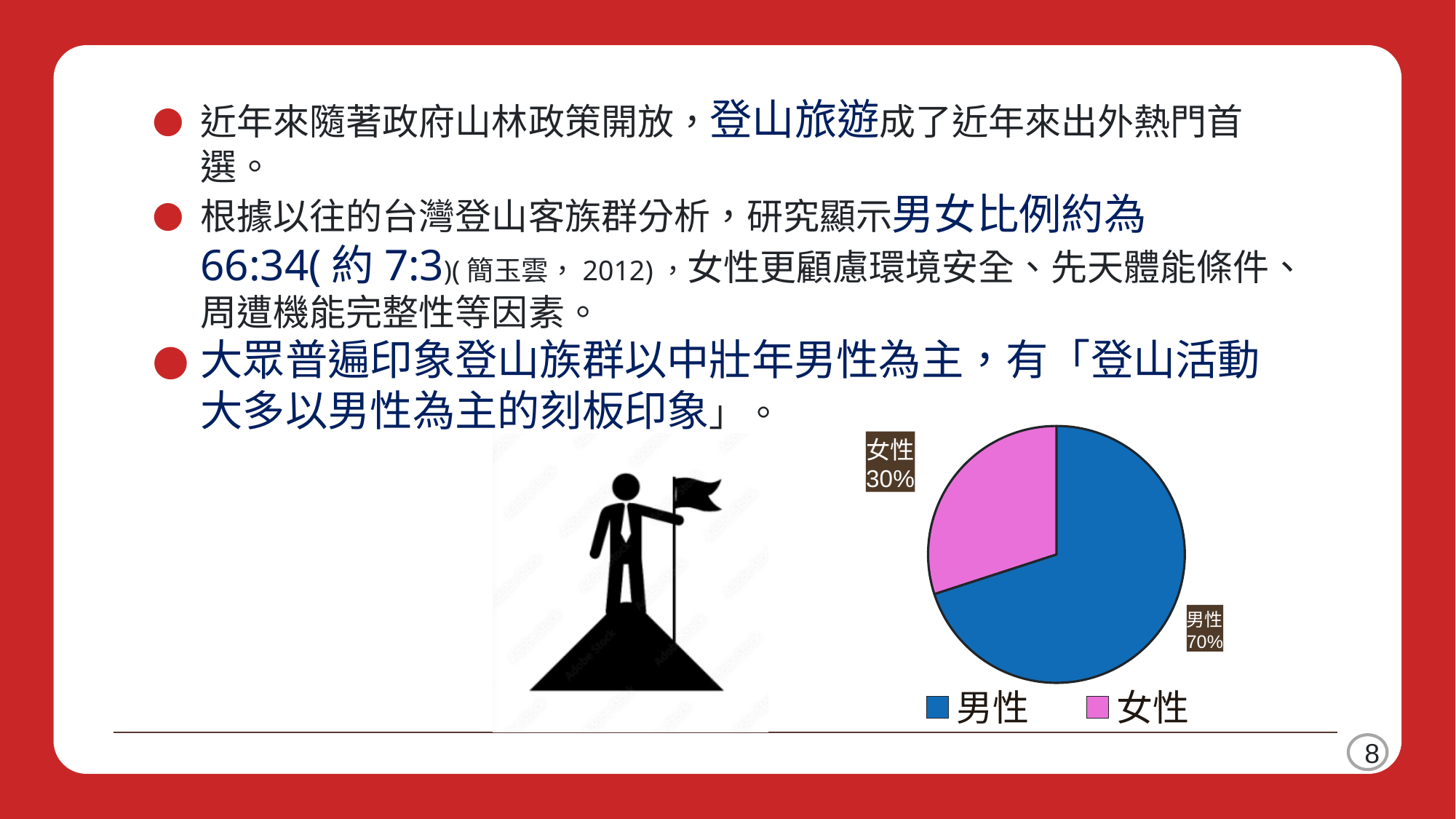
What is the value for 男性 in the pie chart? 70% What is the difference between the 男性 and 女性 shares in the pie chart? 40% Which category has the largest slice in the pie chart? 男性 Which category has the smallest slice in the pie chart? 女性 What share of the pie does the 女性 slice represent? 30% What is the value for 女性 in the pie chart? 30% Which is larger in the pie chart, 男性 or 女性? 男性 What colour is the 女性 slice in the pie chart? pink What kind of chart is shown on the slide? pie chart How many slices does the pie chart have? 2 What colour is the 男性 slice in the pie chart? blue How many entries does the legend of the pie chart list? 2